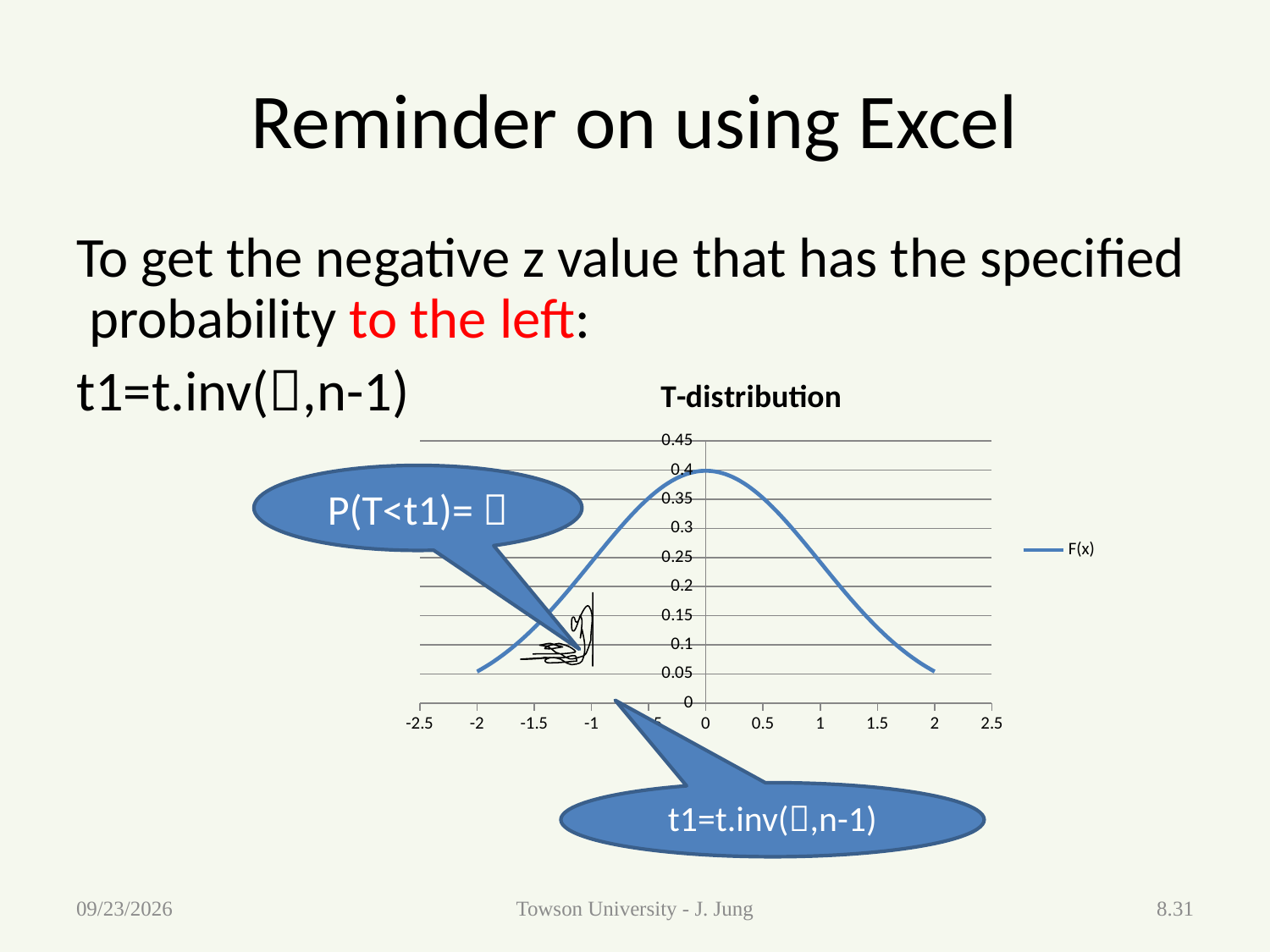
What is the name of the series shown in the chart's legend? F(x) Does the F(x) curve rise or fall as x goes from -2 to 0? rise At which x value does the F(x) curve reach its highest point? 0 How many series does the chart's legend list? 1 Is the value of F(x) at x = -1 greater or less than 0.2? greater Is the value of F(x) at x = 1 greater or less than 0.3? less What is the title of the chart on the slide? T-distribution Which is larger, the value of F(x) at x = 0 or at x = 1.5? x = 0 What kind of chart is shown on the slide? line chart Is the value of F(x) at x = 2 greater or less than 0.1? less Does the F(x) curve rise or fall as x goes from 0 to 2? fall